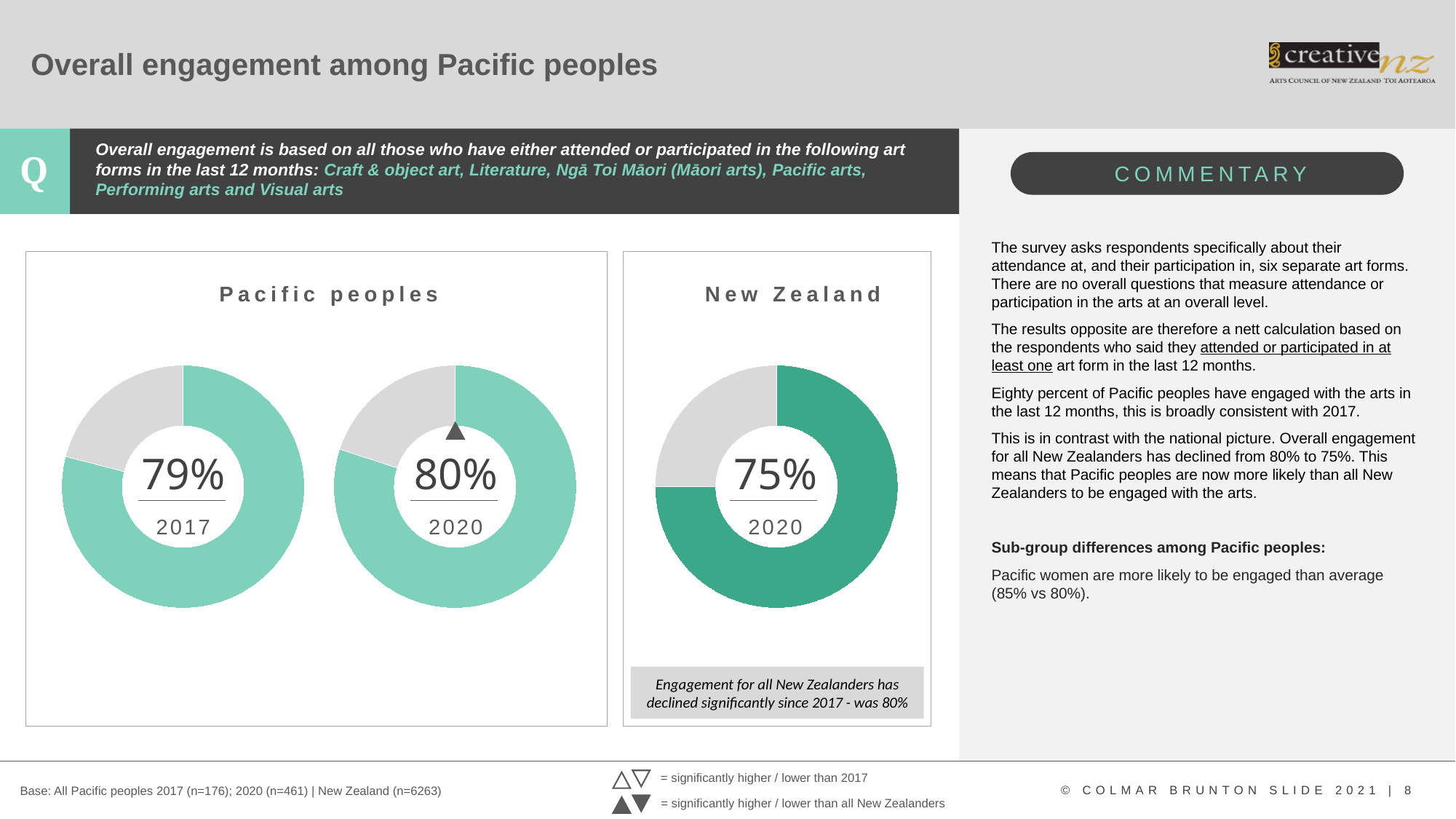
Does the Pacific peoples engagement value rise or fall from 2017 to 2020? Rise What is the difference between the Pacific peoples 2020 value and the New Zealand 2020 value? 5 percentage points In the Pacific peoples chart, what is the engagement value shown for 2017? 79% What kind of chart is used to show the engagement values on this slide? Donut (pie) chart In the New Zealand chart, what is the engagement value shown for 2020? 75% In the Pacific peoples chart, what is the engagement value shown for 2020? 80% According to the note in the New Zealand chart, what was the New Zealand engagement value in 2017? 80% In the Pacific peoples chart, what is the difference between the 2020 and 2017 engagement values? 1 percentage point Across both panels, how many donut charts are shown on the slide? 3 How many donut charts are shown in the Pacific peoples panel? 2 Which is larger, the Pacific peoples 2020 value or the New Zealand 2020 value? Pacific peoples 2020 In the Pacific peoples chart, which year has the higher engagement value, 2017 or 2020? 2020